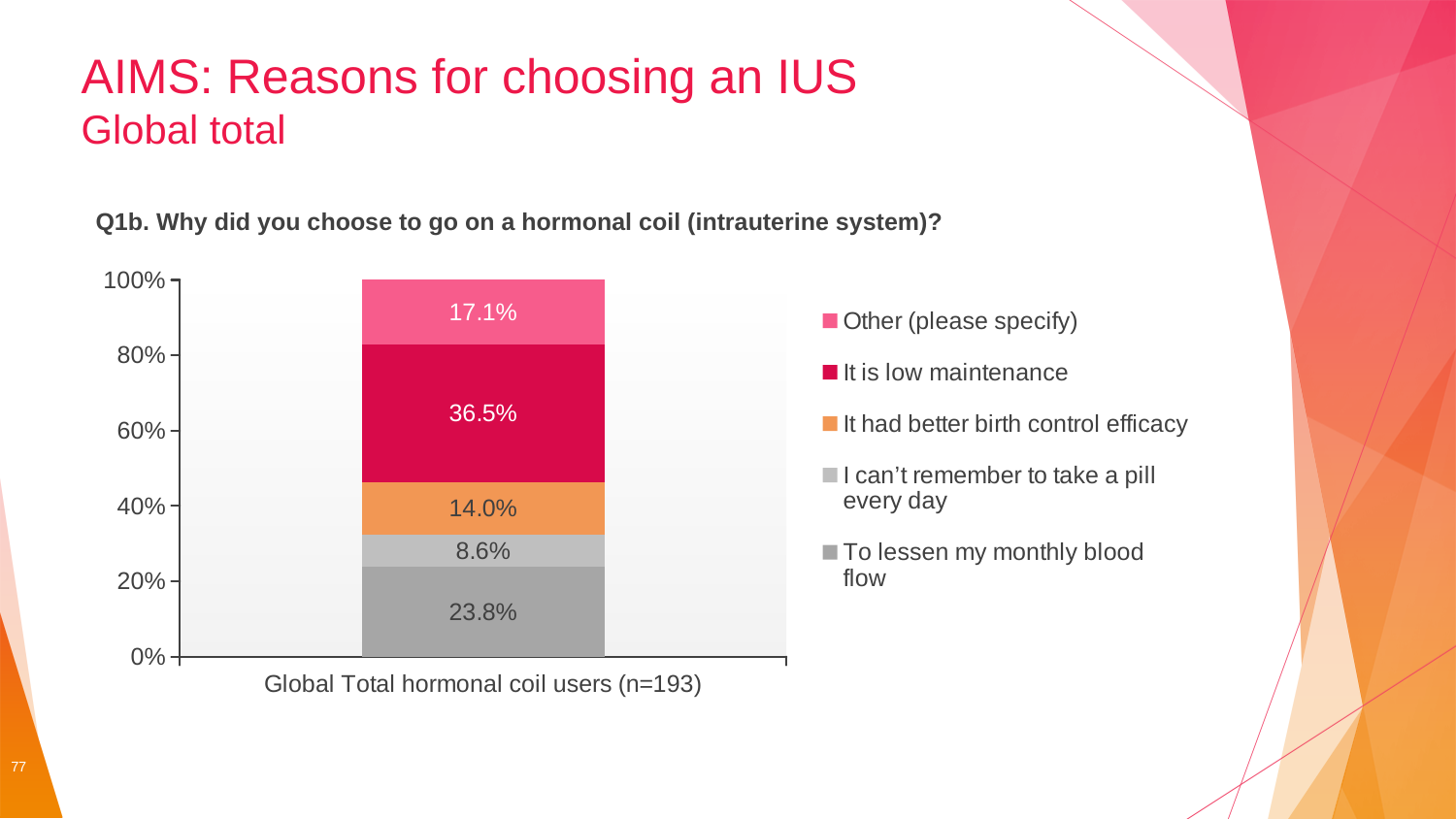
What is the difference in percentage points between "It is low maintenance" and "To lessen my monthly blood flow"? 12.7 percentage points What percentage of respondents chose "Other (please specify)"? 17.1% What percentage of respondents chose "To lessen my monthly blood flow"? 23.8% Which reason has the largest share of the stacked bar? It is low maintenance What kind of chart is shown on the slide? Stacked bar chart Which is larger: the share for "Other (please specify)" or the share for "It had better birth control efficacy"? Other (please specify) What percentage of respondents chose "It is low maintenance" as their reason for choosing an IUS? 36.5% What percentage of respondents chose "I can't remember to take a pill every day"? 8.6% How many series does the legend list? 5 What percentage of respondents chose "It had better birth control efficacy"? 14.0% Which reason has the smallest share of the stacked bar? I can't remember to take a pill every day What is the sample size shown in the x-axis label of the chart? n=193